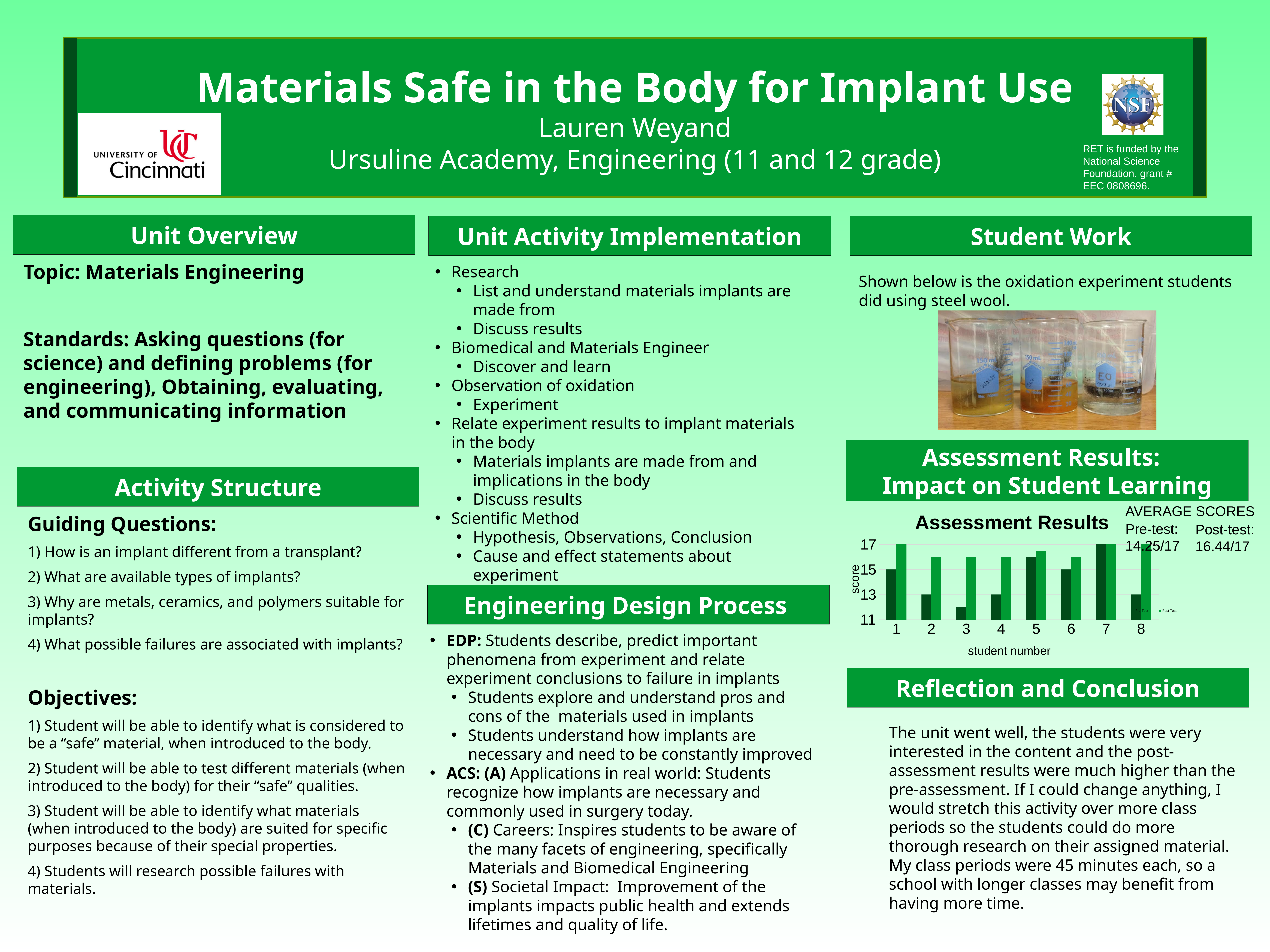
How many series does the legend of the Assessment Results chart list? 2 In the Assessment Results chart, which is larger for student 2, the Pre-Test or the Post-Test score? Post-Test In the Assessment Results chart, is the Post-Test value for student 1 greater or less than 15? greater What is the title of the chart in the Assessment Results section? Assessment Results In the Assessment Results chart, which student has the lowest Pre-Test score? 3 What is the label of the y axis on the Assessment Results chart? score In the Assessment Results chart, is the Post-Test value for student 8 greater or less than 15? greater How many students are shown on the x axis of the Assessment Results chart? 8 In the Assessment Results chart, is the Pre-Test value for student 2 greater or less than 15? less What kind of chart is the Assessment Results chart? bar chart In the Assessment Results chart, which is larger for student 3, the Pre-Test or the Post-Test score? Post-Test